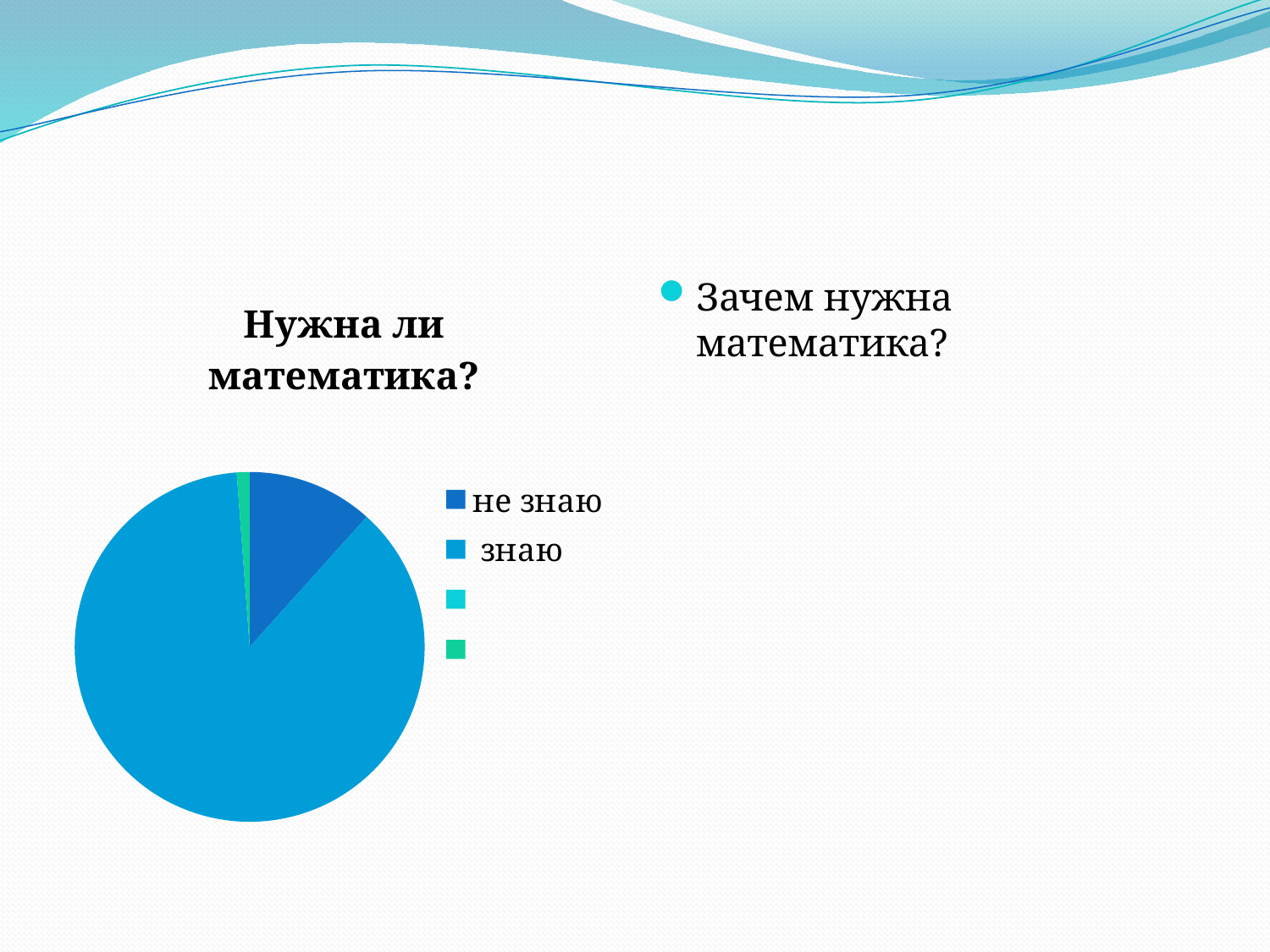
What kind of chart is shown on the slide? pie chart Which category has the largest slice of the pie? знаю How many legend entries have a readable label? 2 Does the "не знаю" slice take up more or less than a quarter of the pie? less Does the "знаю" slice take up more or less than half of the pie? more What is the title of the chart? Нужна ли математика? Which slice is larger, "знаю" or "не знаю"? знаю